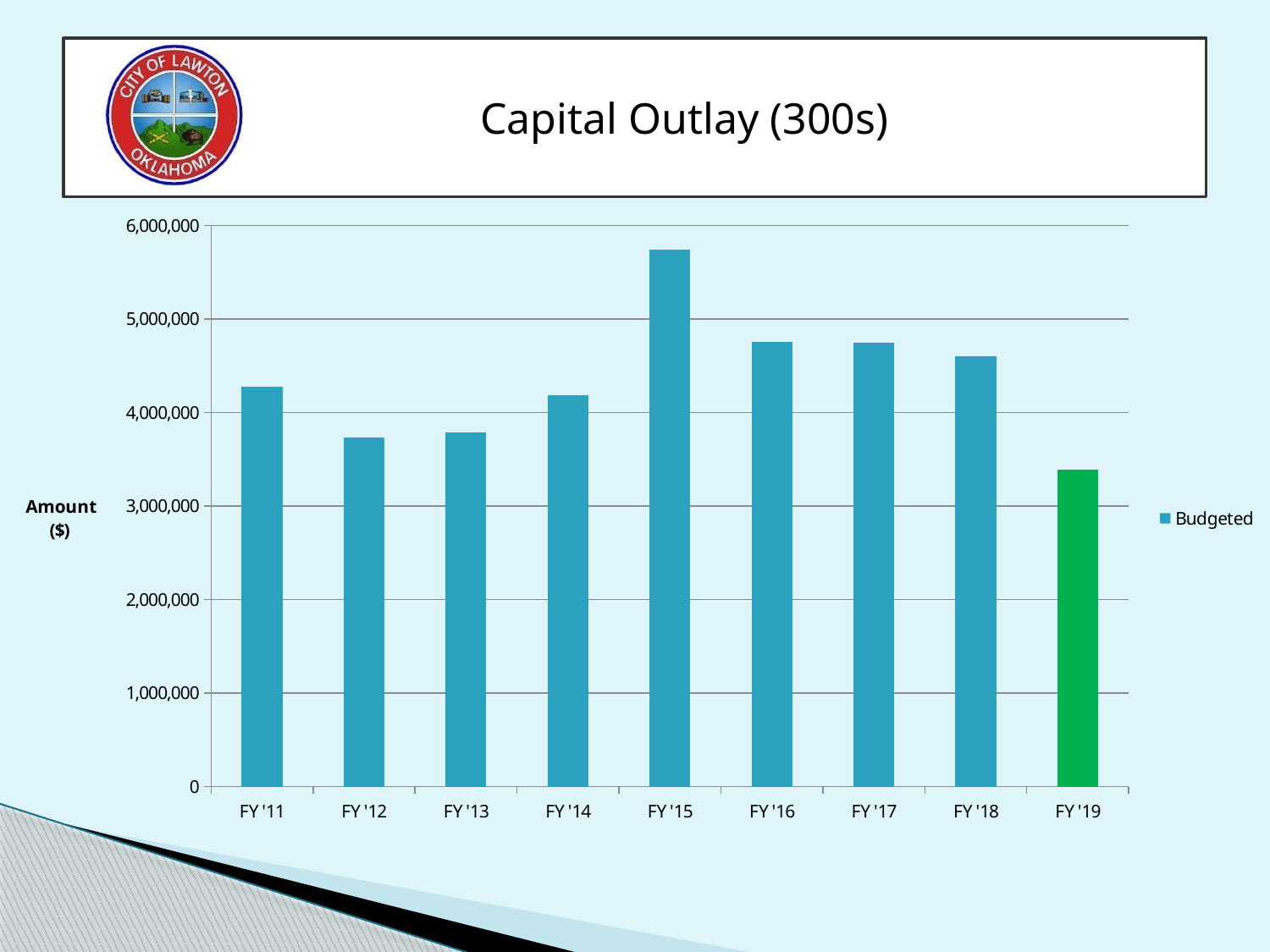
How many fiscal years are shown on the x axis? 9 Is the value for FY '19 greater or less than 4,000,000? less Which fiscal year has the highest Capital Outlay value? FY '15 How many series does the legend list? 1 Do the values rise or fall from FY '15 to FY '19? fall Is the value for FY '11 greater or less than 4,000,000? greater Which is larger, the value for FY '15 or the value for FY '18? FY '15 What kind of chart is shown on the slide? bar chart What is the name of the series listed in the legend? Budgeted Which fiscal year has the lowest Capital Outlay value? FY '19 Is the value for FY '16 greater or less than 5,000,000? less